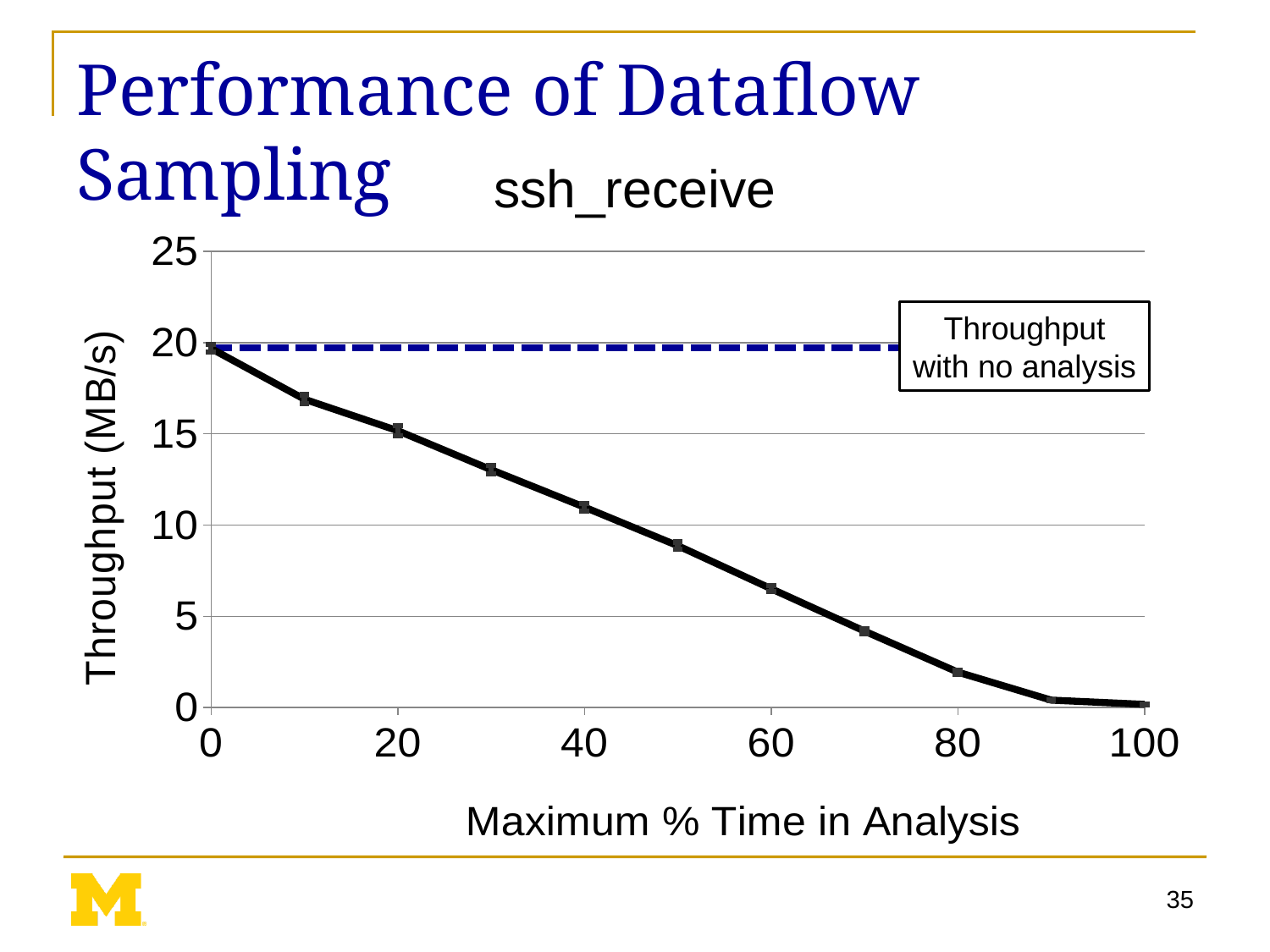
How many data points are plotted on the solid throughput line? 11 Which has the higher throughput: 20% or 60% Maximum Time in Analysis? 20% As Maximum % Time in Analysis increases along the x axis, does the throughput rise or fall? fall At which Maximum % Time in Analysis value is the throughput lowest? 100 Is the throughput at 30% Maximum Time in Analysis greater or less than 15? less Is the throughput at 80% Maximum Time in Analysis greater or less than 5? less At which Maximum % Time in Analysis value is the throughput highest? 0 Is the throughput at 60% Maximum Time in Analysis greater or less than 5? greater What is the title of the chart? ssh_receive What kind of chart is shown on the slide? line chart What is the label of the y axis? Throughput (MB/s)